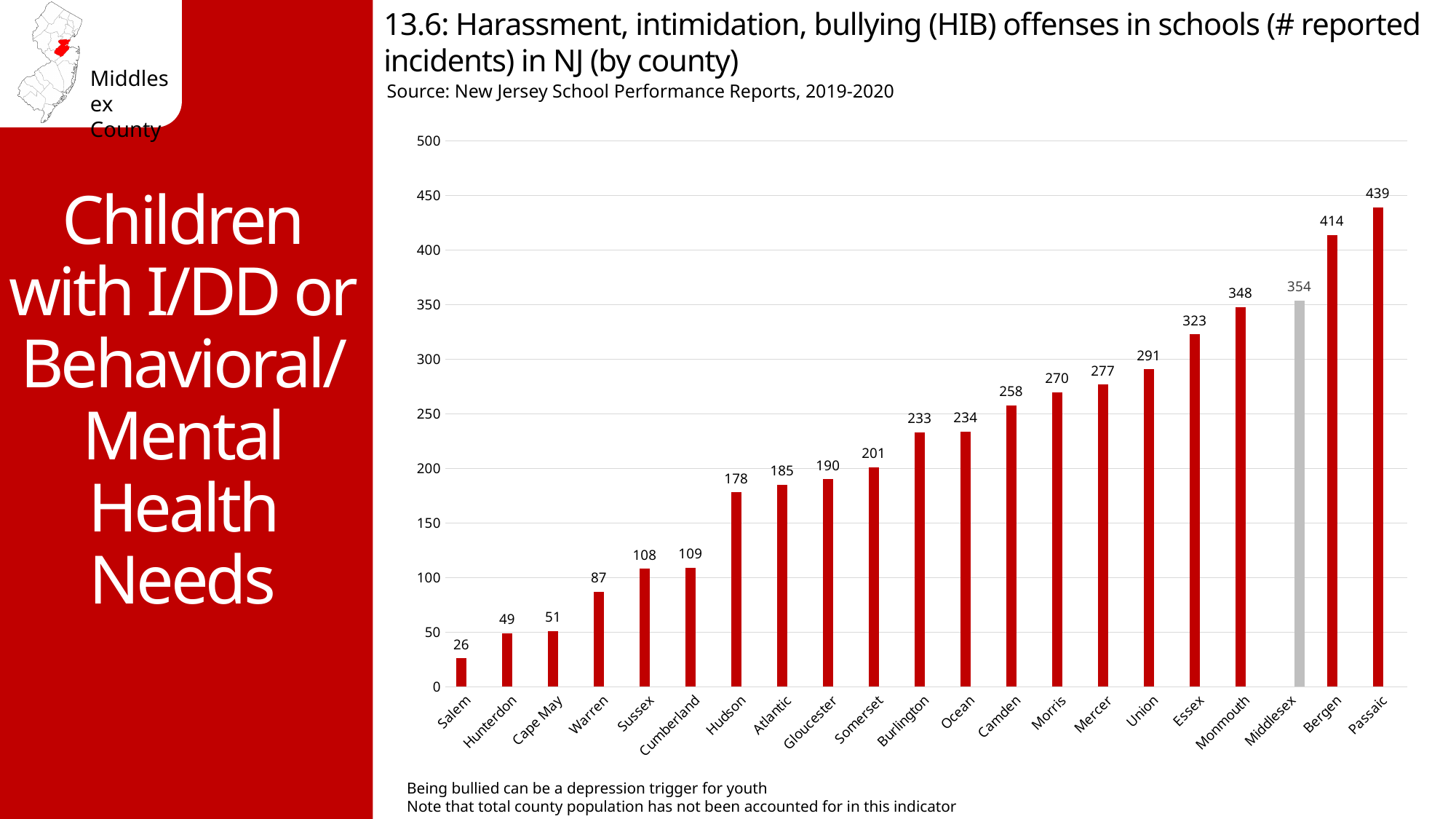
Is the value for Camden greater or less than 250? greater What is the difference between the values for Middlesex and Monmouth? 6 Which has more reported HIB incidents, Essex or Union? Essex Which county has the lowest number of reported HIB incidents? Salem What is the difference between the values for Passaic and Bergen? 25 What kind of chart is shown on the slide? bar chart Which county's bar is coloured grey instead of red? Middlesex What is the number of reported HIB incidents for Hudson? 178 What is the number of reported HIB incidents for Middlesex? 354 Which county has the highest number of reported HIB incidents? Passaic Do the values rise or fall from left to right along the x axis? rise How many counties are shown on the chart? 21